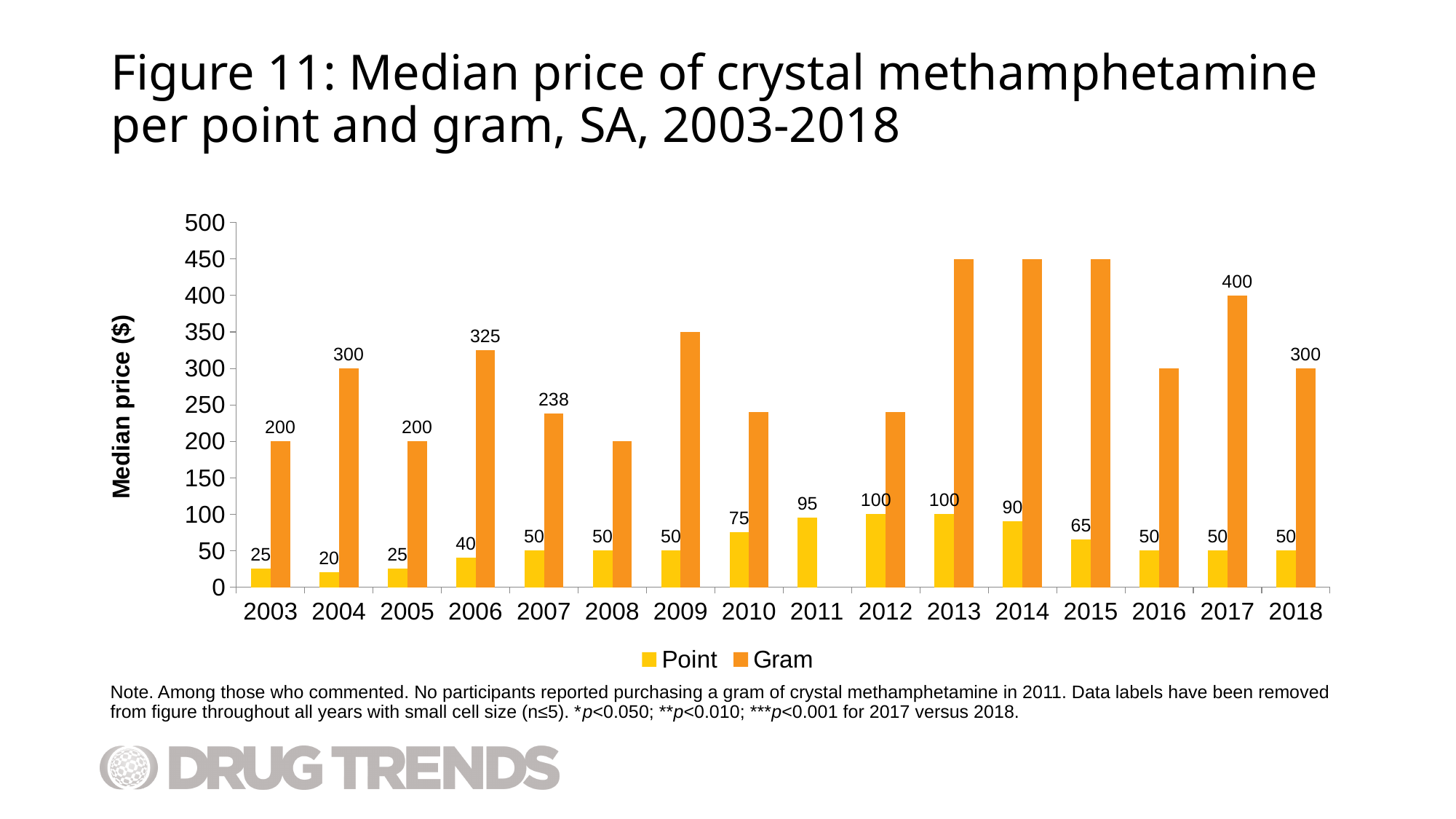
Is the median price per gram in 2010 greater or less than 300? less What is the median price per gram in 2006? 325 Which year has the lowest median price per point? 2004 What is the difference between the median price per gram in 2017 and in 2018? 100 What is the median price per gram in 2017? 400 Is the median price per gram in 2013 greater or less than 400? greater What is the median price per point in 2004? 20 Which is larger, the median price per point in 2010 or in 2014? 2014 What is the median price per point in 2011? 95 What kind of chart is shown on the slide? Bar chart How many years are shown on the x axis? 16 How many series does the legend list? 2